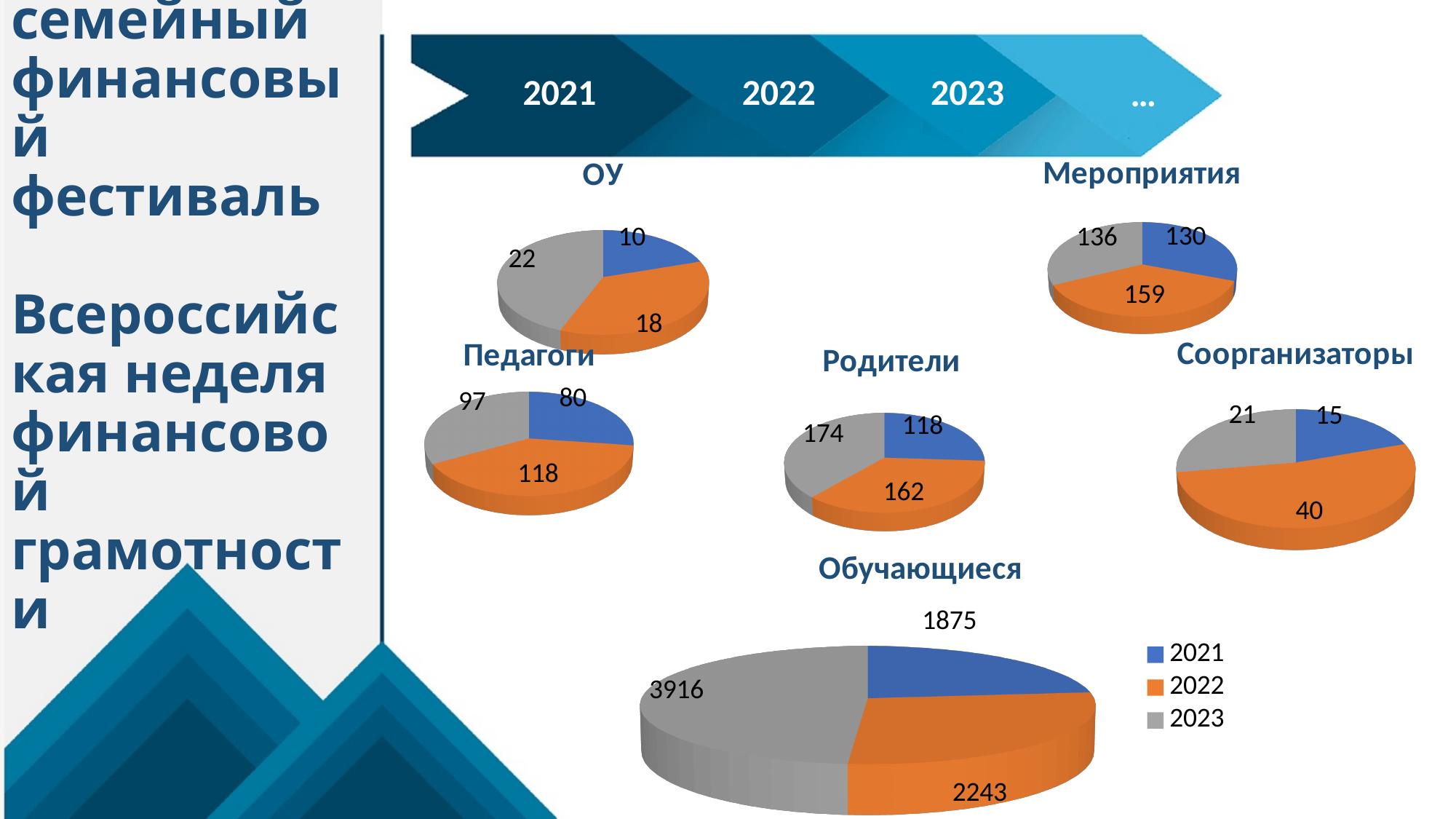
In the "Мероприятия" pie chart, which year has the highest value? 2022 In the "Обучающиеся" pie chart, what is the value for 2023? 3916 In the "Обучающиеся" pie chart, what is the total of the three values? 8034 Which colour represents 2022 in the legend? Orange In the "Педагоги" pie chart, what is the value for 2021? 80 How many series does the legend list? 3 In the "Педагоги" pie chart, what is the difference between the 2022 and 2023 values? 21 What type of chart is the "Обучающиеся" chart? Pie chart In the "Соорганизаторы" pie chart, which is larger: the value for 2022 or the value for 2023? 2022 In the "ОУ" pie chart, what is the value for 2023? 22 In the "Соорганизаторы" pie chart, which year has the lowest value? 2021 In the "Родители" pie chart, what is the difference between the 2023 and 2021 values? 56